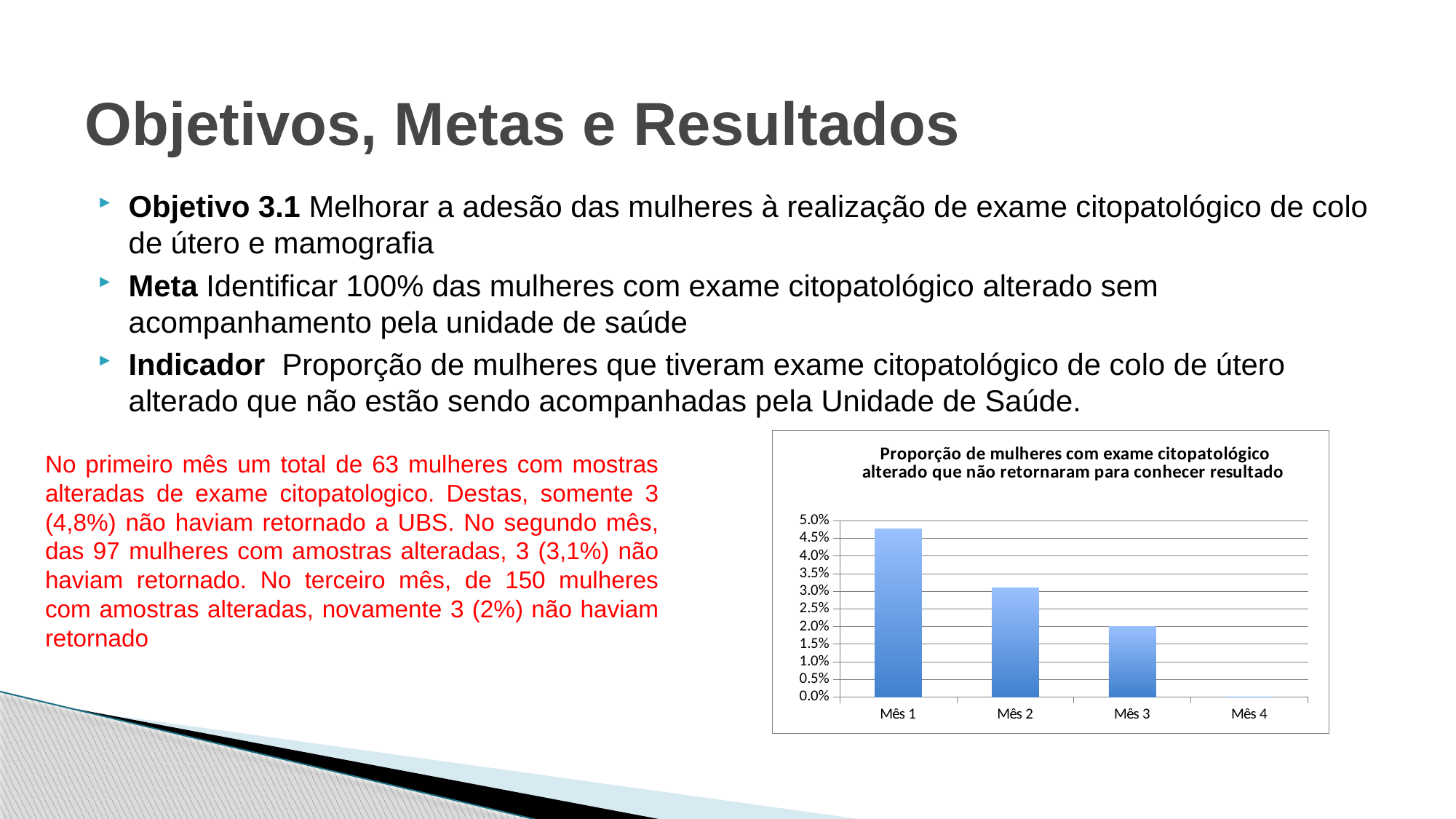
Which is larger, the value for Mês 2 or the value for Mês 3? Mês 2 Is the value for Mês 2 greater or less than 3.5%? less What kind of chart is shown on the slide? bar chart Do the bar values rise or fall from Mês 1 to Mês 3? fall Which month has the highest bar in the chart? Mês 1 Is the value for Mês 3 greater or less than 2.5%? less What is the title of the chart? Proporção de mulheres com exame citopatológico alterado que não retornaram para conhecer resultado Is the value for Mês 1 greater or less than 4.5%? greater Which month on the x axis has no bar plotted? Mês 4 Which is larger, the value for Mês 1 or the value for Mês 2? Mês 1 How many categories are shown on the x axis of the chart? 4